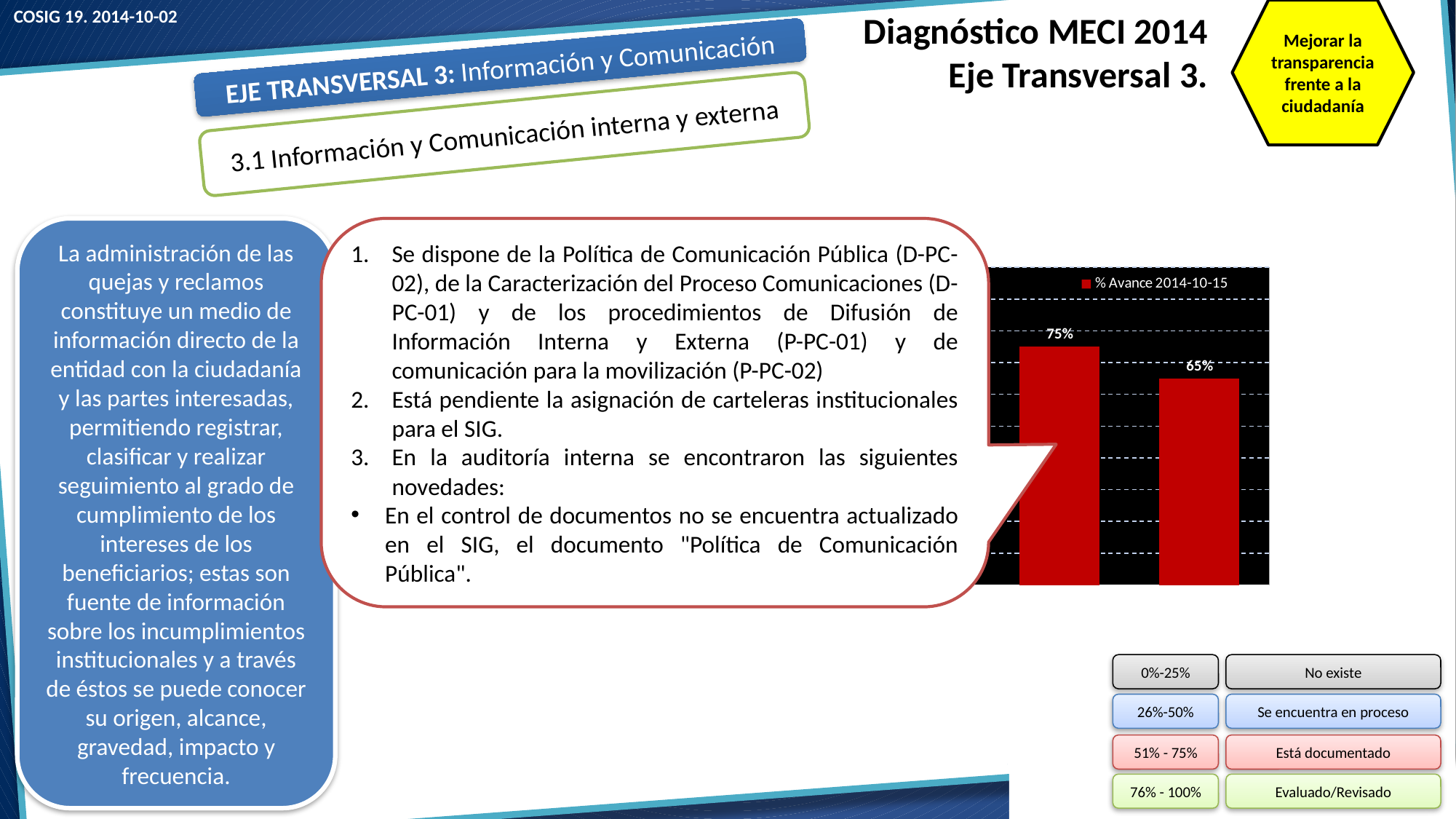
What colour are the bars in the chart? red What is the series name shown in the chart legend? % Avance 2014-10-15 What is the value shown on the left bar of the chart? 75% What is the value shown on the right bar of the chart? 65% How many series does the chart legend list? 1 What type of chart is shown on the slide? bar chart Which bar is taller in the chart, the left one or the right one? the left one What is the difference between the left bar and the right bar in the chart? 10%